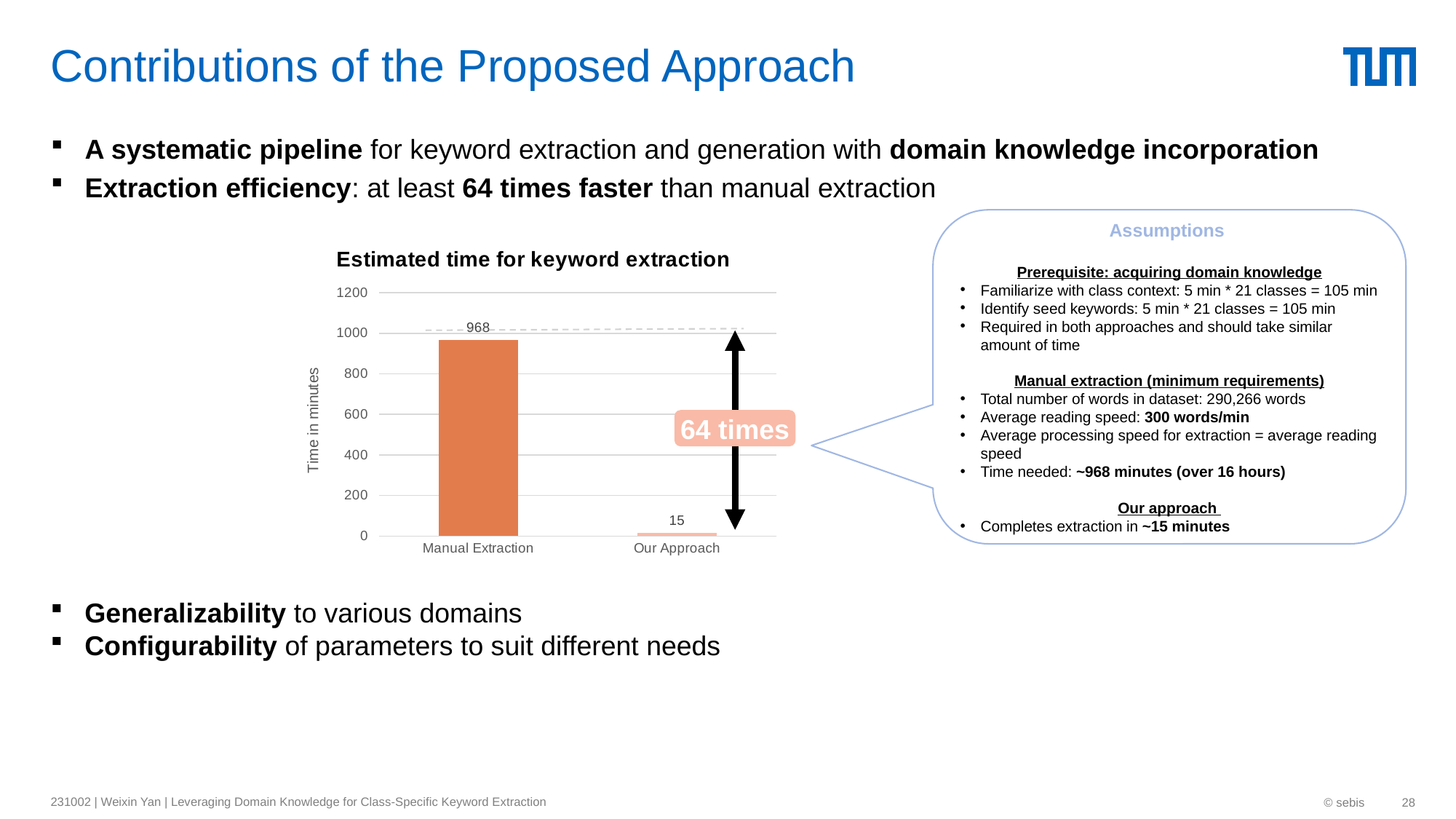
What is the difference in minutes between Manual Extraction and Our Approach? 953 Which takes more time, Manual Extraction or Our Approach? Manual Extraction What is the title of the chart? Estimated time for keyword extraction What is the estimated time in minutes for Manual Extraction? 968 What is the estimated time in minutes for Our Approach? 15 Is the value for Manual Extraction greater or less than 800? greater What is the label of the y axis of the chart? Time in minutes Which category has the highest estimated time for keyword extraction? Manual Extraction What kind of chart is shown on the slide? Bar chart Is the value for Our Approach greater or less than 200? less Which category has the lowest estimated time for keyword extraction? Our Approach How many categories are shown on the x axis of the chart? 2